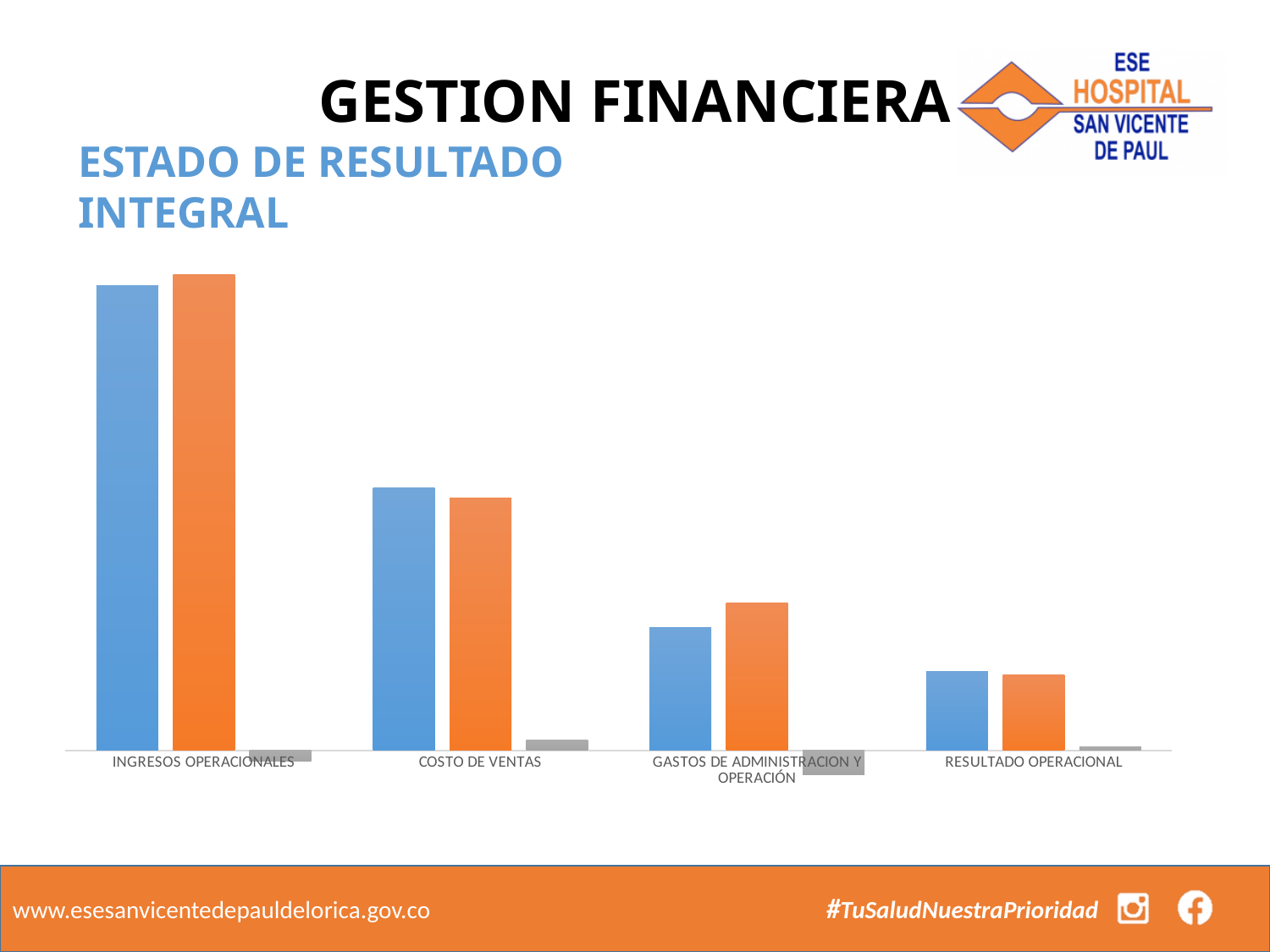
Do the blue bars rise or fall from left to right across the categories? fall Within the GASTOS DE ADMINISTRACION Y OPERACIÓN category, is the blue bar or the orange bar taller? orange Which category has the tallest bars in the chart? INGRESOS OPERACIONALES Is the blue bar for COSTO DE VENTAS taller or shorter than the blue bar for INGRESOS OPERACIONALES? shorter What is the label of the last category on the x axis of the chart? RESULTADO OPERACIONAL How many bars are plotted for each category in the chart? 3 Which category has the shortest orange bar in the chart? RESULTADO OPERACIONAL What kind of chart is shown on the slide? bar chart How many categories are shown on the x axis of the chart? 4 Which category has the shortest blue bar in the chart? RESULTADO OPERACIONAL Is the orange bar for GASTOS DE ADMINISTRACION Y OPERACIÓN taller or shorter than the orange bar for RESULTADO OPERACIONAL? taller